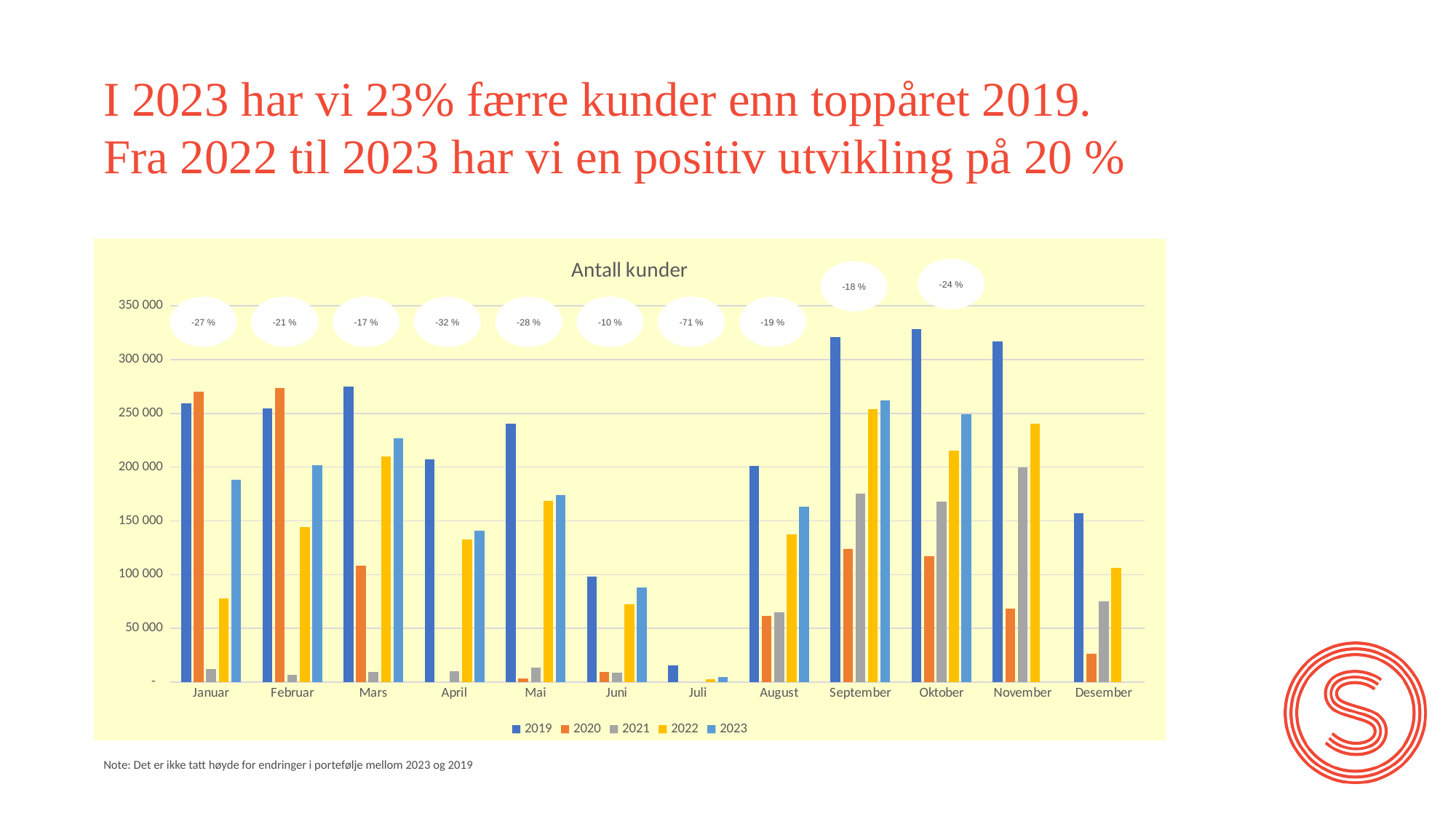
What kind of chart is shown on the slide? bar chart Is the value for 2022 in Januar greater or less than 100 000? less How many series does the legend of the 'Antall kunder' chart list? 5 In Mai, which is larger: the 2019 value or the 2023 value? 2019 How many months are shown on the x axis of the 'Antall kunder' chart? 12 Is the value for 2019 in Oktober greater or less than 300 000? greater What is the title of the chart? Antall kunder Is the value for 2023 in Mars greater or less than 200 000? greater What percentage is shown in the bubble above Juli? -71 % In which month is the 2019 bar lowest? Juli What percentage is shown in the bubble above April? -32 %